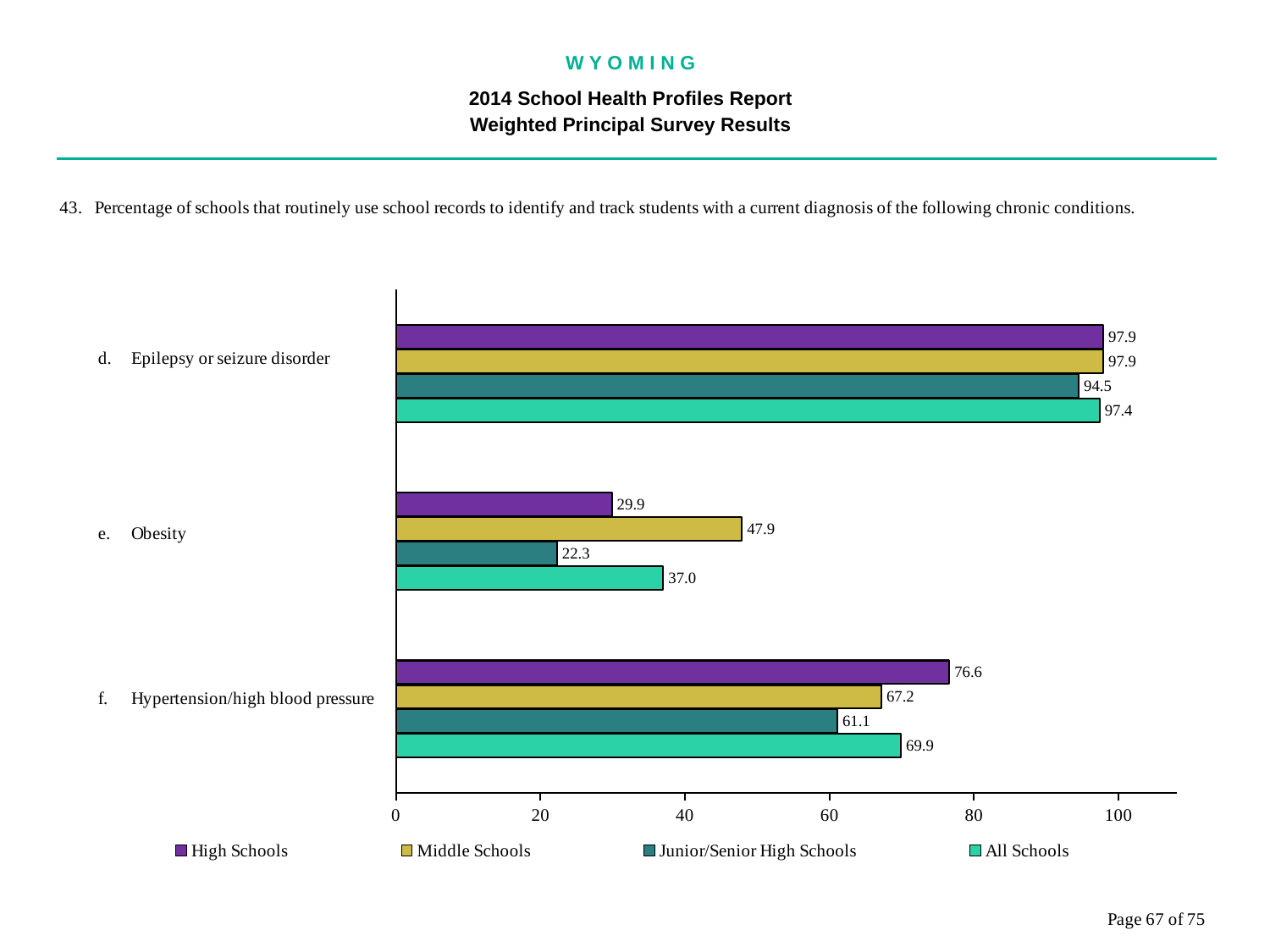
What is the value for Junior/Senior High Schools for Hypertension/high blood pressure? 61.1 What is the value for All Schools for Epilepsy or seizure disorder? 97.4 What kind of chart is shown on the slide? bar chart How many chronic condition categories are shown on the chart? 3 How many series does the legend list? 4 Which series has the highest value for Hypertension/high blood pressure? High Schools Which series is shown in purple in the legend? High Schools Which is larger for Obesity: the All Schools value or the High Schools value? All Schools Which category has the lowest value for High Schools? Obesity What is the difference between the Middle Schools and High Schools values for Obesity? 18.0 Is the value for Junior/Senior High Schools for Obesity greater or less than 40? less What is the value for Middle Schools for Obesity? 47.9